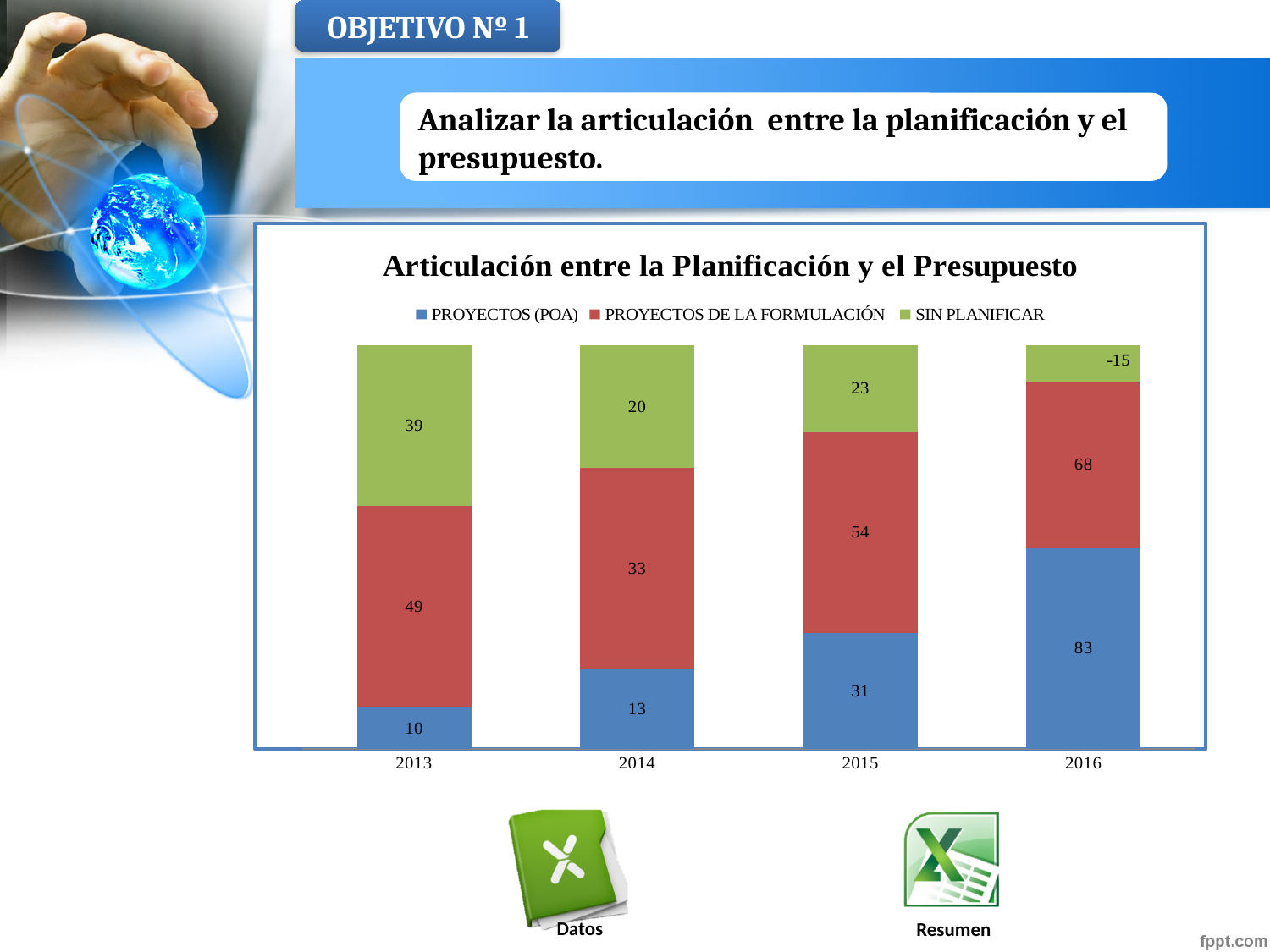
What kind of chart is shown on the slide? Stacked bar chart In which year is the PROYECTOS (POA) value highest? 2016 What is the difference between the PROYECTOS (POA) values for 2016 and 2015? 52 What is the value for PROYECTOS (POA) in 2016? 83 In which year is the PROYECTOS DE LA FORMULACIÓN value lowest? 2014 What is the value for SIN PLANIFICAR in 2013? 39 Do the PROYECTOS (POA) values rise or fall from 2013 to 2016? Rise What is the value for SIN PLANIFICAR in 2016? -15 Which is larger: SIN PLANIFICAR in 2014 or SIN PLANIFICAR in 2015? SIN PLANIFICAR in 2015 How many series does the legend list? 3 How many years are shown on the x axis? 4 What is the value for PROYECTOS DE LA FORMULACIÓN in 2015? 54